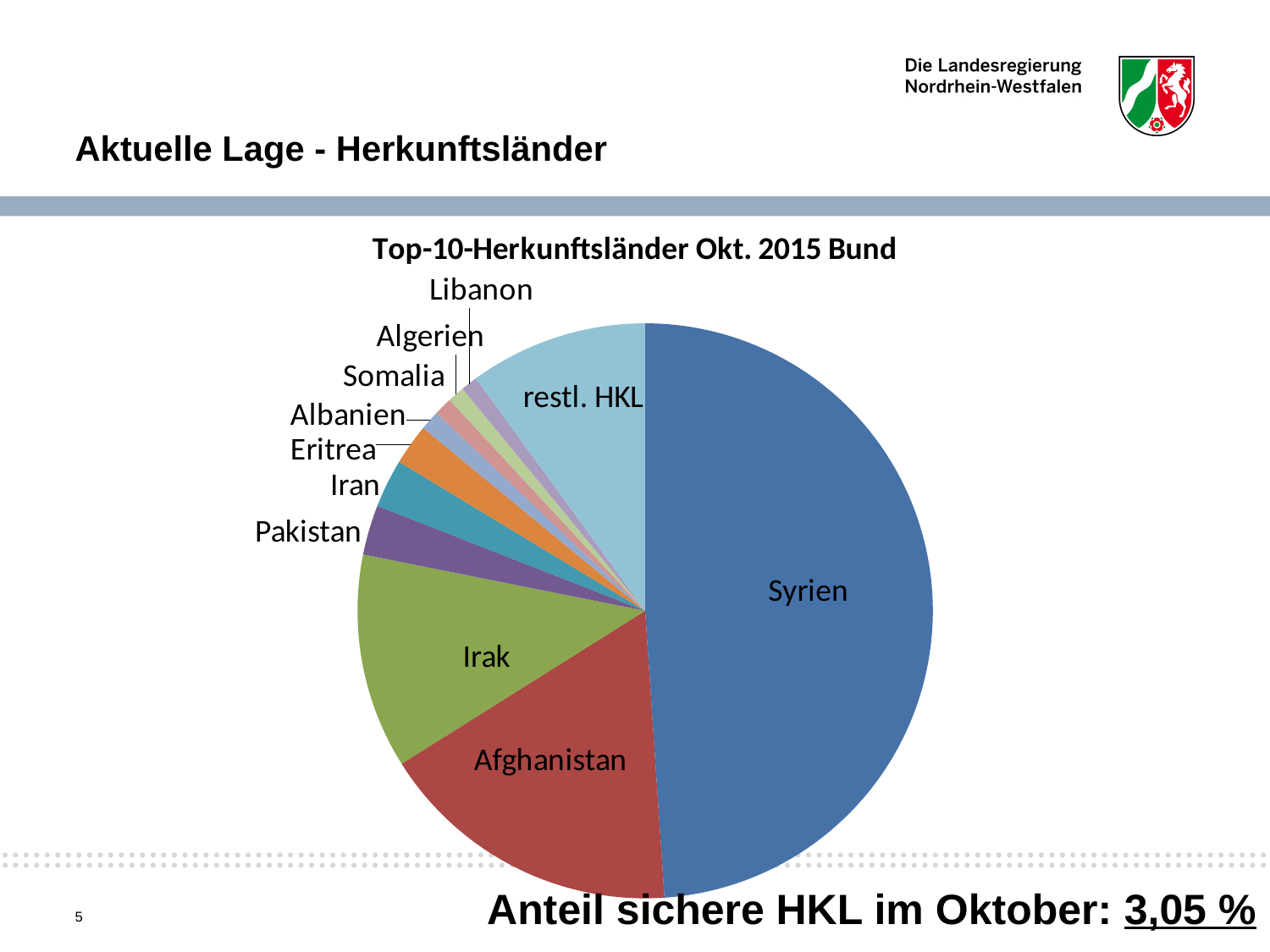
Which slice is larger, Pakistan or Eritrea? Pakistan Which slice is larger, restl. HKL or Iran? restl. HKL Which slice is larger, Irak or Pakistan? Irak What kind of chart is shown on the slide? pie chart What is the title of the chart? Top-10-Herkunftsländer Okt. 2015 Bund Which country has the largest slice of the pie? Syrien What colour is the Syrien slice? blue How many slices does the pie chart have? 11